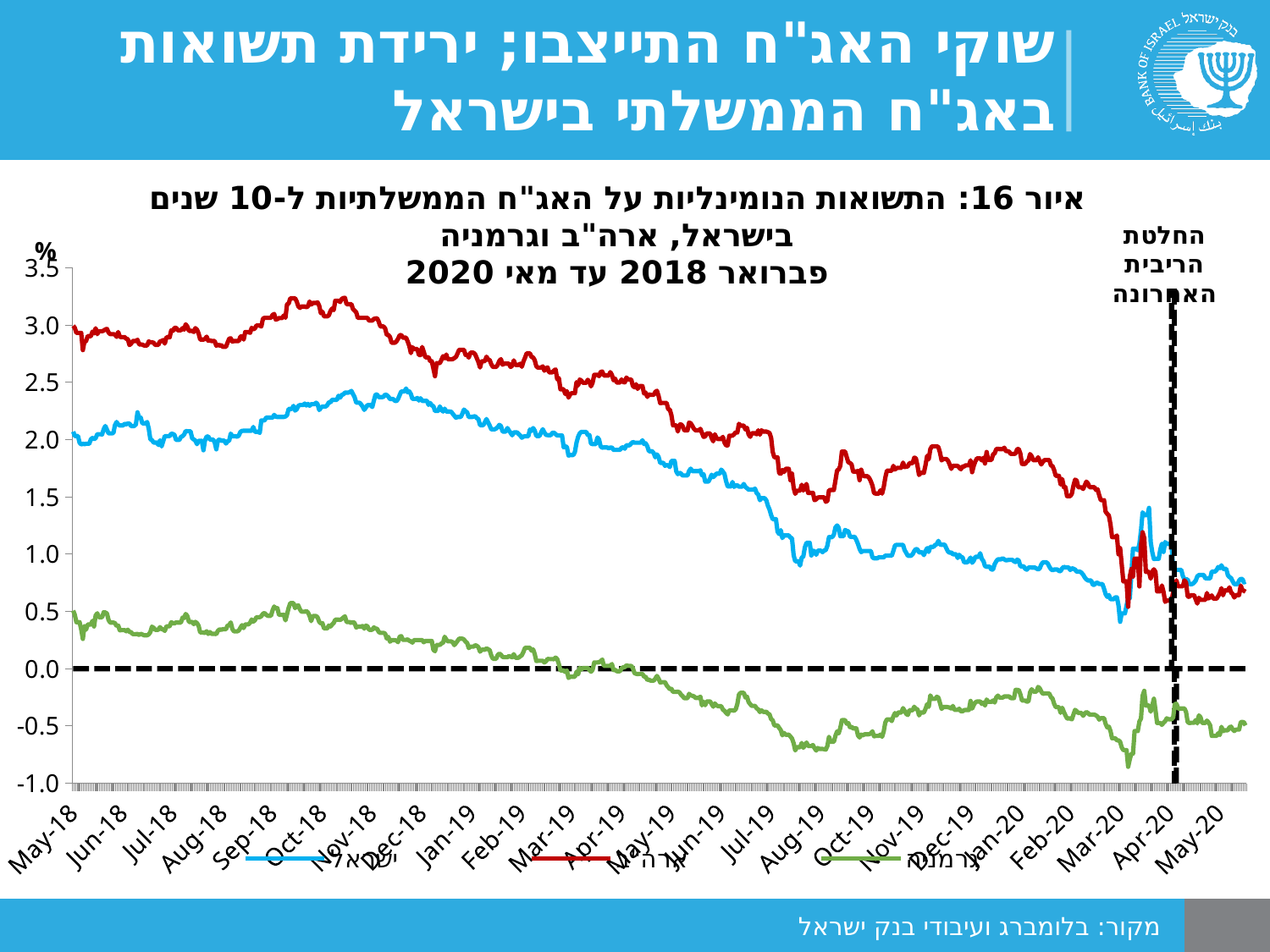
Which series is plotted in green in the chart? גרמניה Is the value of the blue (ישראל) series in Jan-20 greater or less than 1.5? less Is the value of the blue (ישראל) series in May-18 greater or less than 1.5? greater Which series is plotted in red in the chart? ארה"ב How many series does the legend of the chart list? 3 Do the values of the red (ארה"ב) series generally rise or fall from May-18 to May-20? fall Is the value of the green (גרמניה) series in Aug-19 greater or less than 0.0? less What kind of chart is shown on the slide? line chart In Oct-18, which series is higher: ארה"ב or ישראל? ארה"ב Which series has the lowest values throughout the period shown? גרמניה